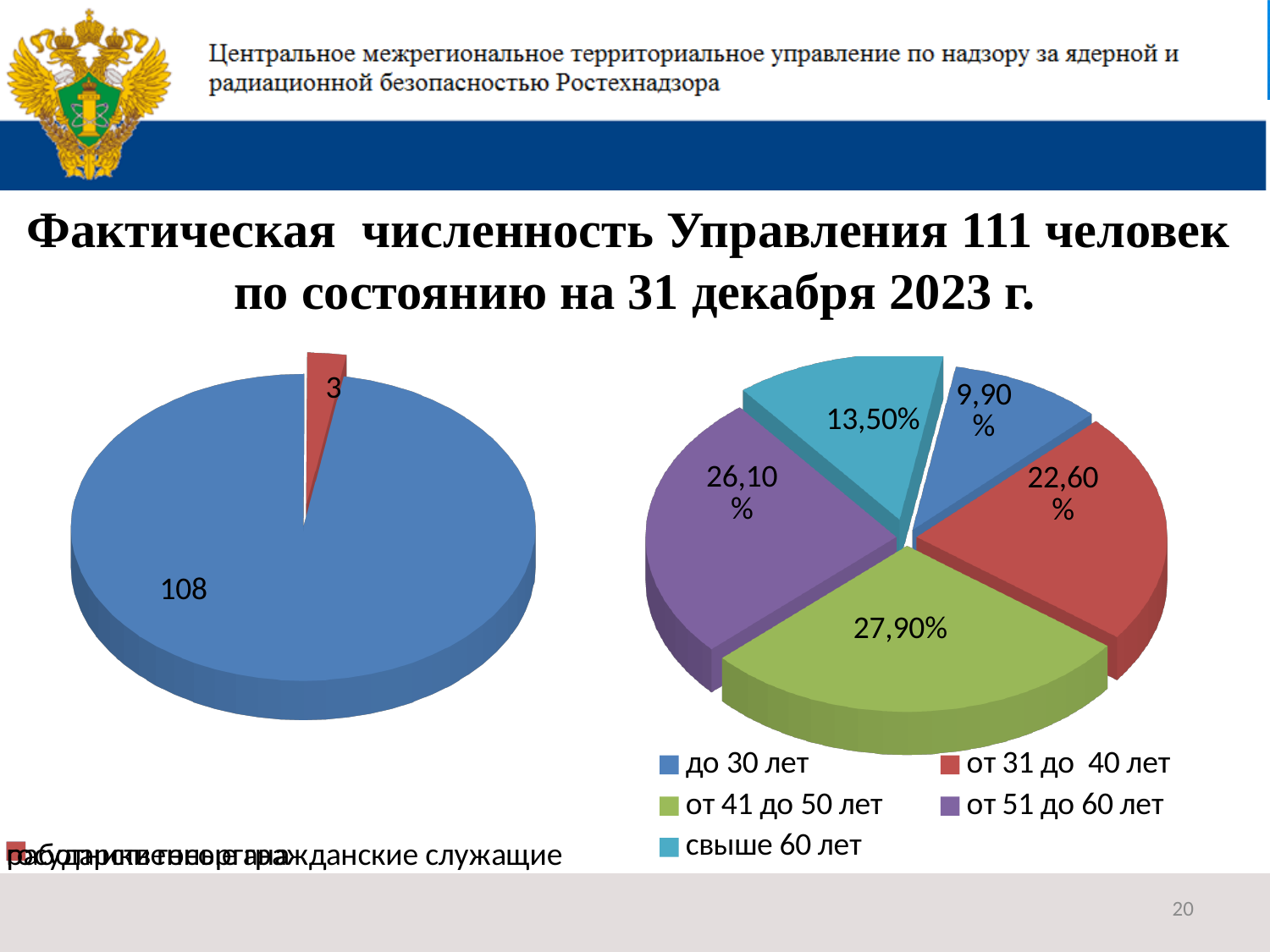
In the pie chart on the right, what is the difference between the shares for 'от 31 до 40 лет' and 'от 51 до 60 лет'? 3,50% In the pie chart on the right, which age group has the largest share? от 41 до 50 лет In the pie chart on the left, what is the value of the large blue slice? 108 How many slices does the pie chart on the left have? 2 In the pie chart on the left, what is the difference between the two slice values? 105 What type of chart is the chart on the left of the slide? pie chart In the pie chart on the left, what is the value of the small red slice? 3 In the pie chart on the right, which age group has the smallest share? до 30 лет In the pie chart on the right, what is the share for 'до 30 лет'? 9,90% In the pie chart on the right, what is the share for 'от 41 до 50 лет'? 27,90% In the pie chart on the right, what is the share for 'свыше 60 лет'? 13,50% How many age groups does the legend of the pie chart on the right list? 5